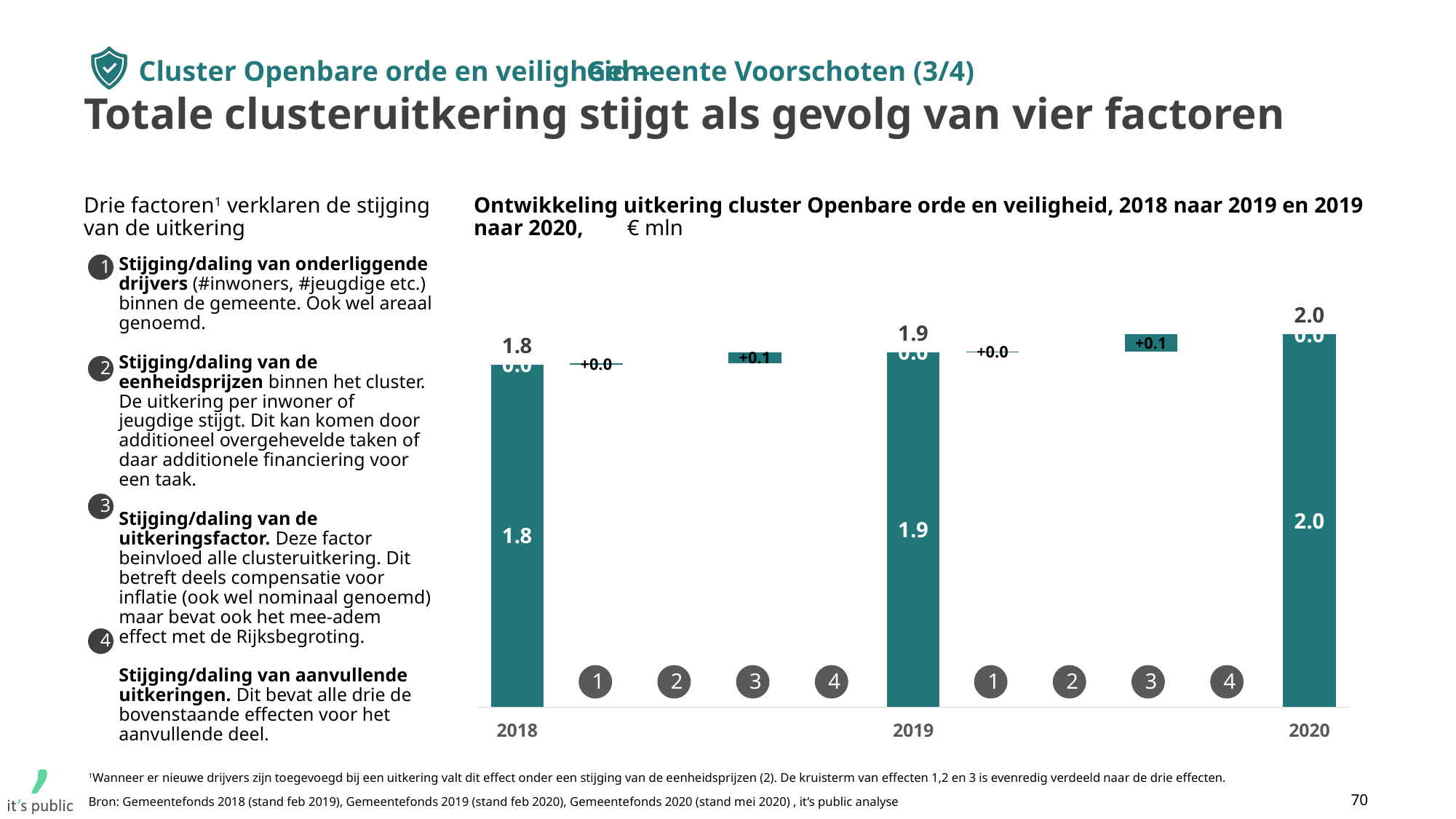
What is the labelled effect of factor 3 between 2018 and 2019? +0.1 What is the labelled effect of factor 1 between 2019 and 2020? +0.0 What is the total cluster payment shown for 2020? 2.0 Which year has the lowest total cluster payment? 2018 What is the total cluster payment shown for 2018? 1.8 Which year has the highest total cluster payment? 2020 What unit is stated in the chart title? € mln What is the difference between the 2020 total and the 2018 total? 0.2 What is the total cluster payment shown for 2019? 1.9 Is the total for 2019 larger or smaller than the total for 2018? larger How many year totals are shown in the chart? 3 Do the total cluster payments rise or fall from 2018 to 2020? rise